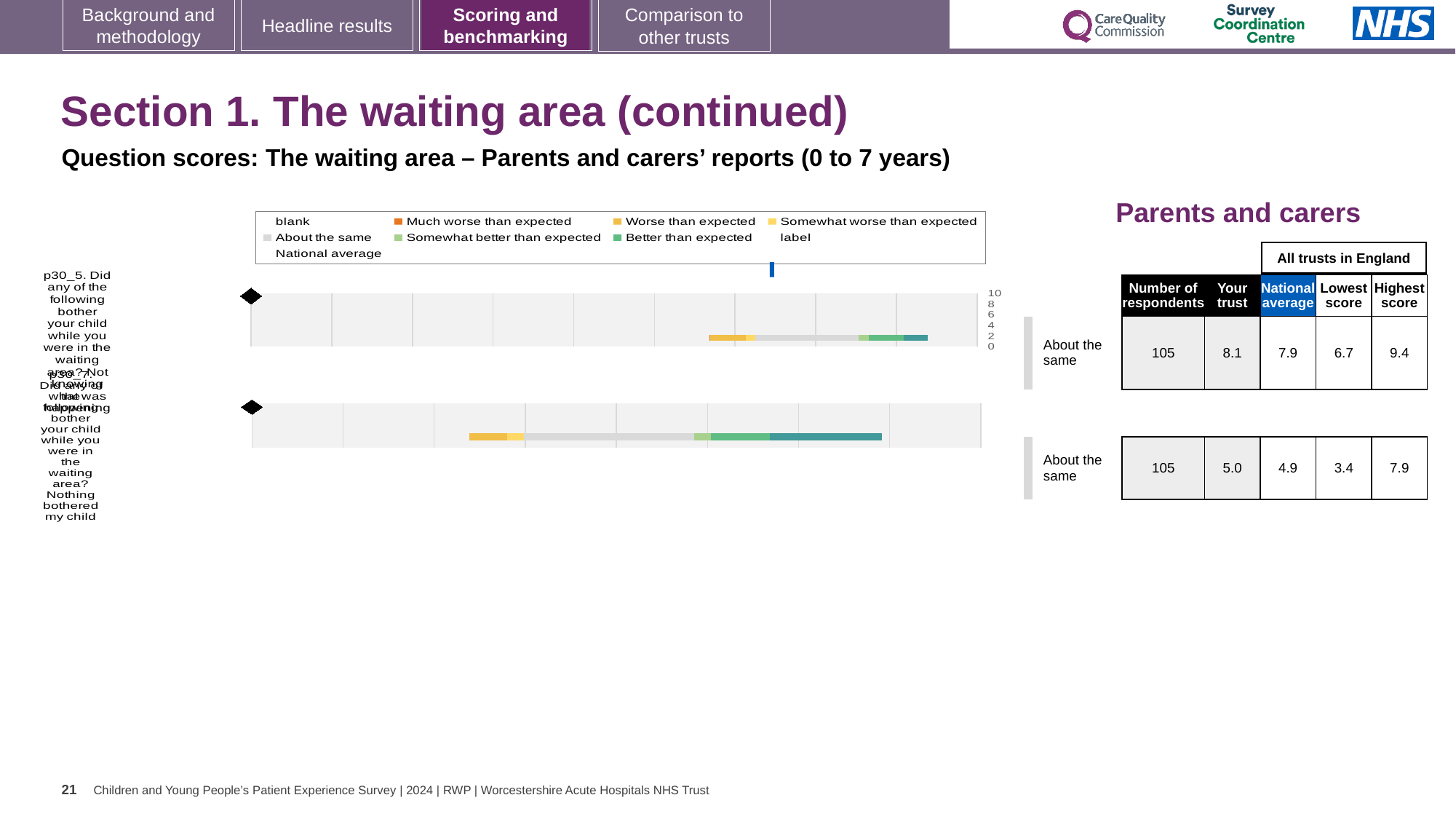
What kind of chart is shown on the slide? bar chart In the table, what is the national average for the second question (p30_7, Nothing bothered my child)? 4.9 What is the difference between the highest score and the lowest score for the first question (p30_5)? 2.7 What benchmark category is shown next to both question bars? About the same How many question bars are plotted in the chart? 2 How many entries does the chart legend list? 9 What colour represents 'Better than expected' in the chart legend? teal green In the table, what is the 'Your trust' score for the first question (p30_5, Not knowing what was happening)? 8.1 Which question has the higher 'Highest score' in the table, p30_5 or p30_7? p30_5 How many respondents are listed for the first question in the table? 105 What is the difference between the highest score and the lowest score for the second question (p30_7)? 4.5 For the first question (p30_5), which is larger: the 'Your trust' score or the national average? Your trust